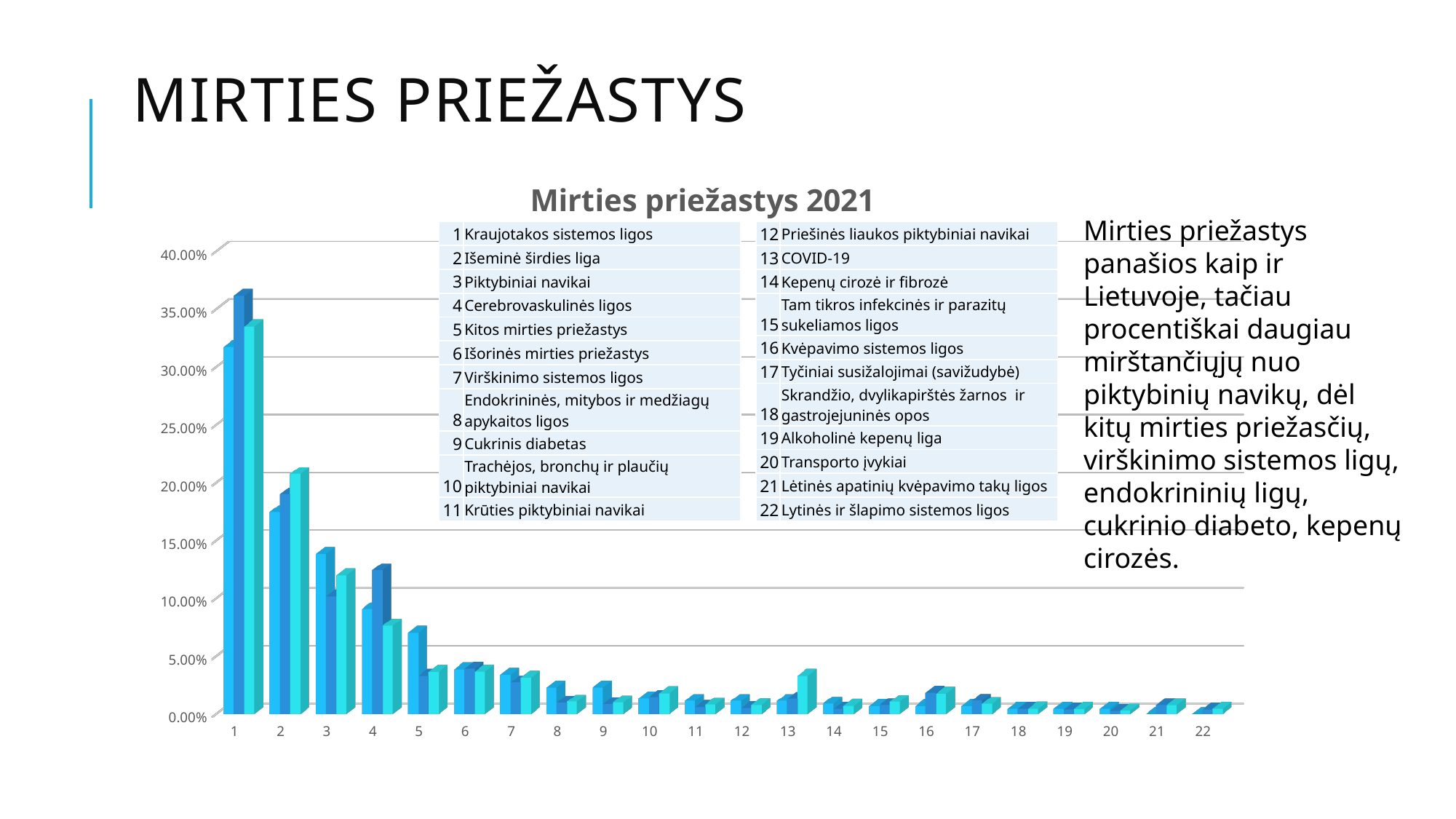
How many numbered categories are plotted along the x axis of the chart? 22 Are the values for category 13 greater or less than 5.00%? less Which category has the highest values in the chart? 1 Are the values for category 2 greater or less than 25.00%? less What is the title of the chart? Mirties priežastys 2021 According to the table on the chart, which cause of death does category 13 represent? COVID-19 Are the values for category 1 greater or less than 30.00%? greater What kind of chart is shown on the slide? bar chart Do the values generally rise or fall from category 1 to category 22 along the x axis? fall Which category has larger values, category 1 or category 2? 1